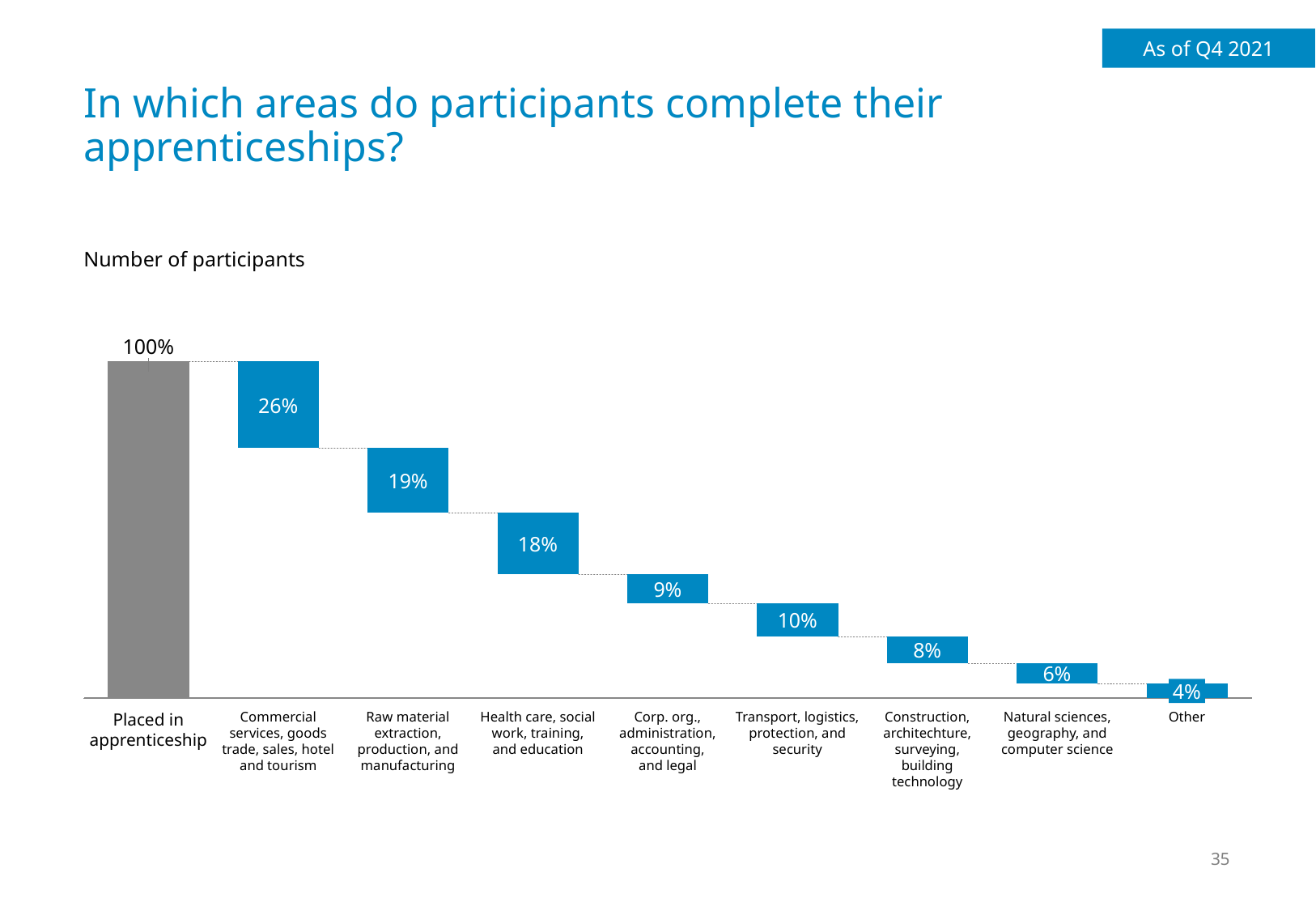
What percentage is shown for health care, social work, training, and education? 18% What percentage of participants complete their apprenticeship in commercial services, goods trade, sales, hotel and tourism? 26% Which apprenticeship area has the lowest share of participants? Other What is the difference in percentage points between commercial services (26%) and raw material extraction, production, and manufacturing (19%)? 7% What value is labelled on the 'Placed in apprenticeship' bar? 100% What kind of chart is shown on the slide? Waterfall chart What date reference is shown in the top-right corner of the slide? As of Q4 2021 Which apprenticeship area has the highest share of participants? Commercial services, goods trade, sales, hotel and tourism What percentage is shown for construction, architechture, surveying, building technology? 8% Which has a larger share: transport, logistics, protection, and security or corp. org., administration, accounting, and legal? Transport, logistics, protection, and security What percentage is shown for the 'Other' category? 4% How many apprenticeship areas are shown, excluding the 'Placed in apprenticeship' total bar? 8